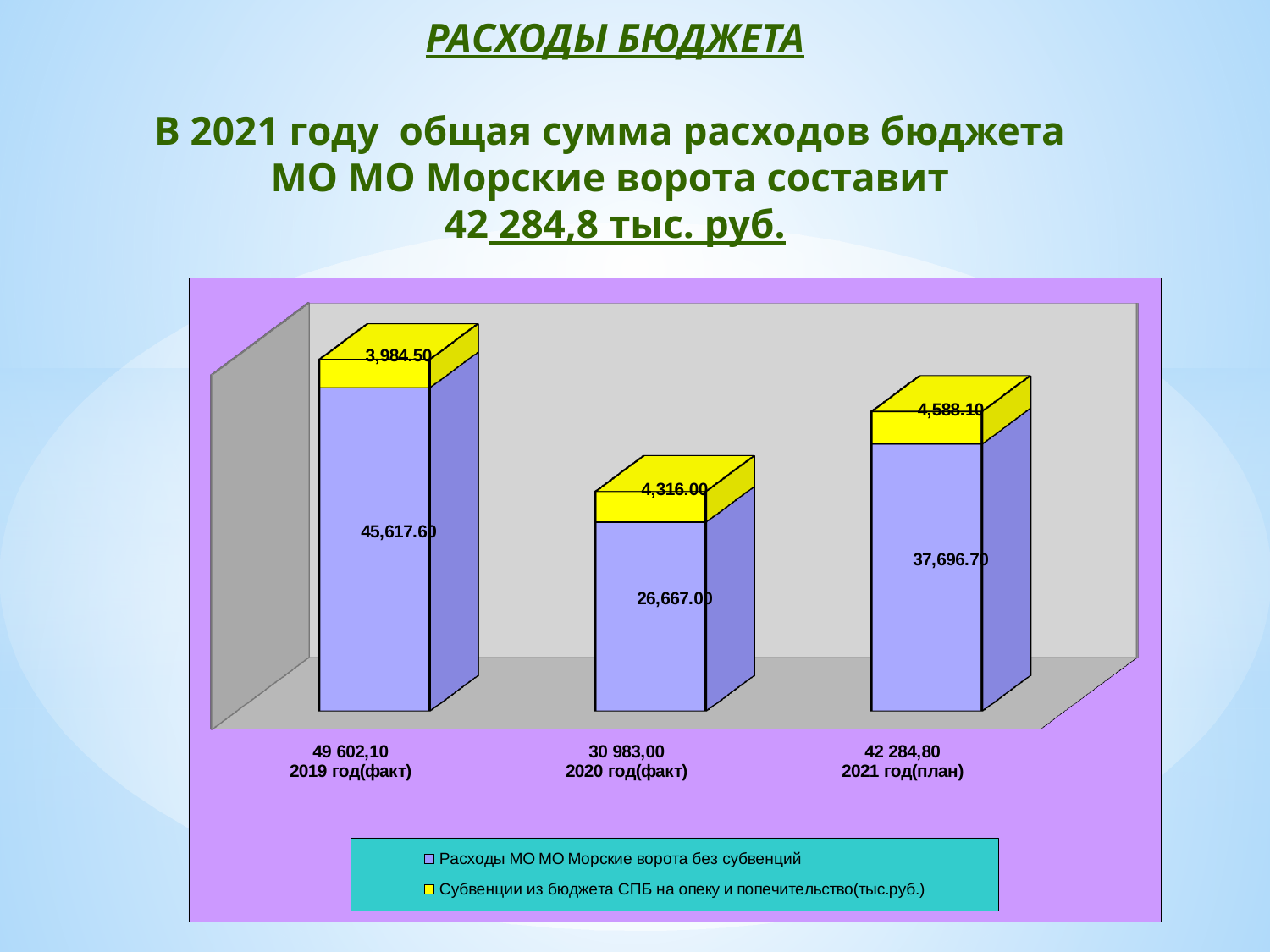
Which year has the lowest value for 'Расходы МО МО Морские ворота без субвенций'? 2020 год(факт) What is the total of the stacked bar for 2021 год(план)? 42 284,80 How many years (categories) are plotted on the chart? 3 Which colour represents 'Субвенции из бюджета СПБ на опеку и попечительство(тыс.руб.)' in the chart? yellow What is the value of 'Расходы МО МО Морские ворота без субвенций' for 2019 год(факт)? 45,617.60 What is the value of 'Расходы МО МО Морские ворота без субвенций' for 2021 год(план)? 37,696.70 What is the value of 'Субвенции из бюджета СПБ на опеку и попечительство' for 2020 год(факт)? 4,316.00 What kind of chart is shown on the slide? stacked bar chart How many series does the legend list? 2 Which year has the highest value for 'Субвенции из бюджета СПБ на опеку и попечительство'? 2021 год(план) What is the value of 'Субвенции из бюджета СПБ на опеку и попечительство' for 2021 год(план)? 4,588.10 What is the difference between the 'Расходы МО МО Морские ворота без субвенций' values for 2019 год(факт) and 2020 год(факт)? 18,950.60